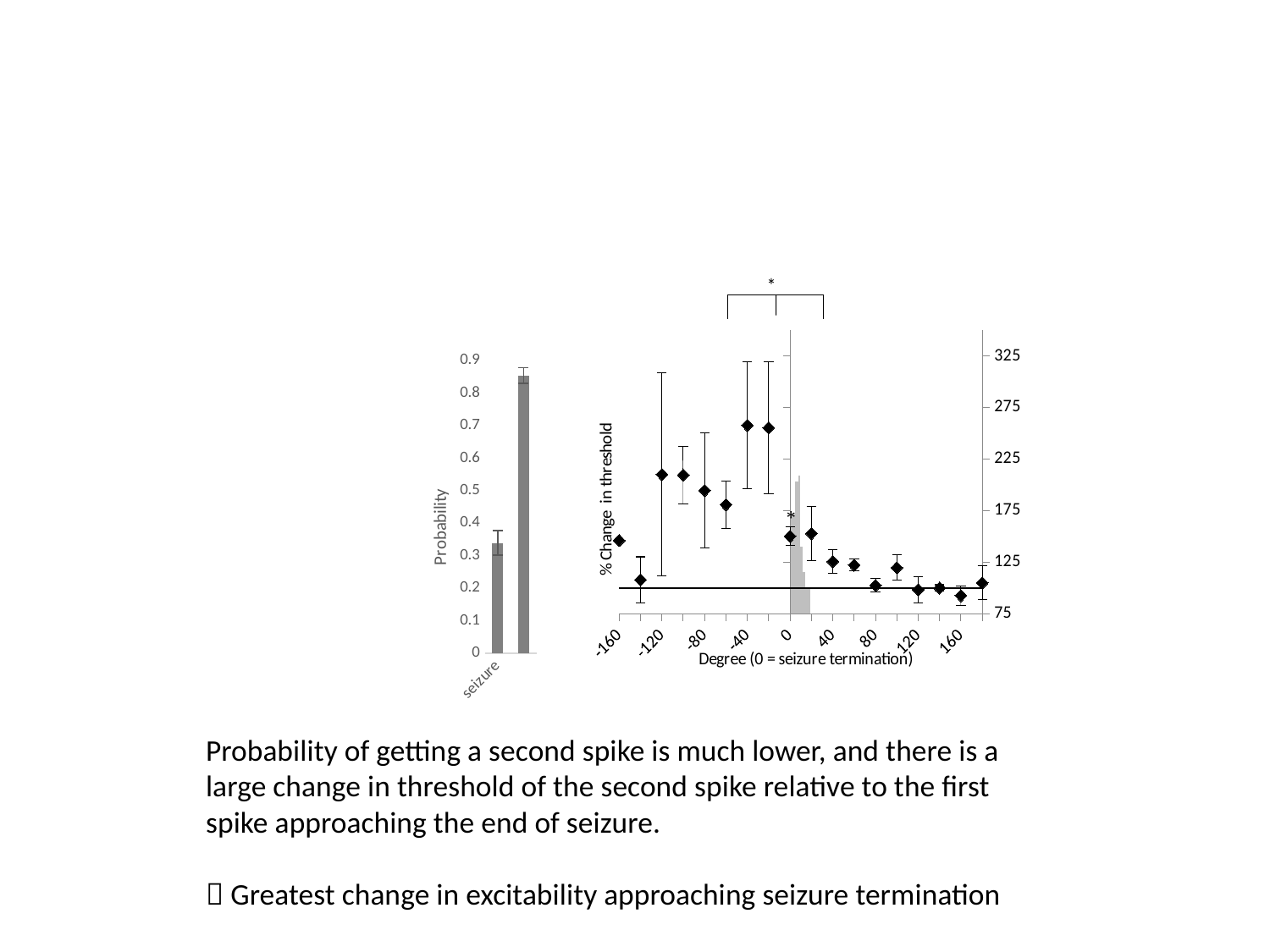
In the left-hand chart, how many bars are plotted? 2 In the left-hand chart, is the value for seizure greater or less than 0.5? less In the right-hand chart, is the value at 0 degrees greater or less than 125? greater In the right-hand chart, which is larger: the value at -20 degrees or the value at 80 degrees? -20 degrees In the right-hand chart, is the value at 160 degrees greater or less than 125? less What kind of chart is the left-hand chart on the slide? bar chart In the right-hand chart, do the values generally rise or fall as the degree goes from 0 to 160? fall In the left-hand chart, what is the y-axis title? Probability In the right-hand chart, what is the x-axis title? Degree (0 = seizure termination) In the left-hand chart, what is the highest value shown on the y axis? 0.9